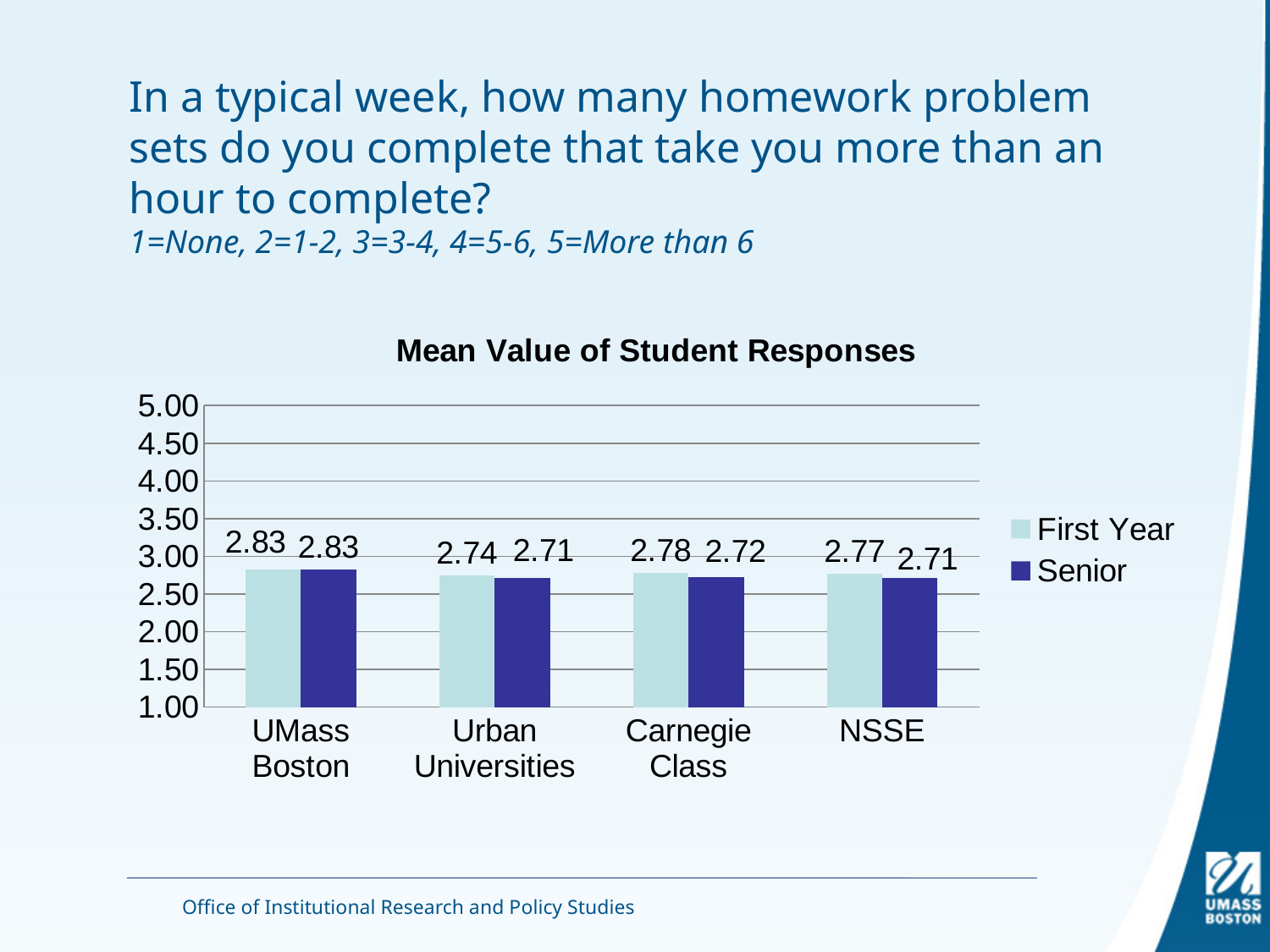
Which category has the highest First Year value? UMass Boston What kind of chart is shown on the slide? Bar chart How many series does the legend list? 2 What is the title of the chart? Mean Value of Student Responses What is the Senior value for NSSE? 2.71 How many categories are shown on the x axis? 4 What is the First Year value for Carnegie Class? 2.78 What is the difference between the First Year and Senior values for Carnegie Class? 0.06 Which is larger, the First Year value for NSSE or the Senior value for NSSE? First Year Which category has the lowest First Year value? Urban Universities What is the First Year value for UMass Boston? 2.83 What is the Senior value for Urban Universities? 2.71